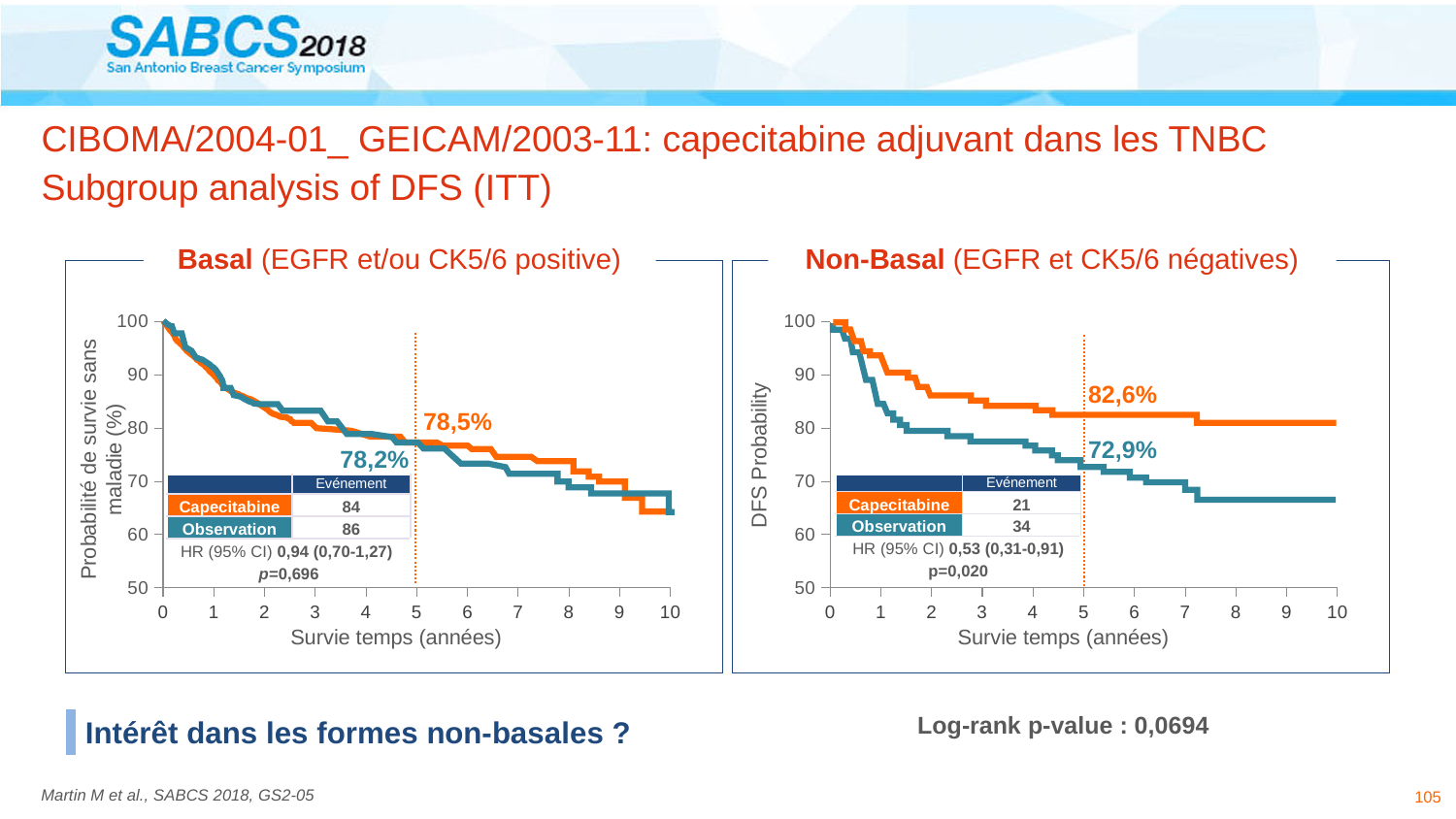
In the Basal chart, what is the 5-year survival probability labelled for the Observation curve? 78,2% In the Basal chart, do the survival curves rise or fall as time increases along the x axis? fall In the Non-Basal chart, what is the 5-year DFS probability labelled for the Capecitabine curve? 82,6% In the Non-Basal chart, which curve has the higher labelled 5-year DFS value, Capecitabine or Observation? Capecitabine In the Non-Basal chart, is the Observation curve at 10 years greater or less than 70? less In the Basal chart, what is the 5-year survival probability labelled for the Capecitabine curve? 78,5% In the Basal chart, how many events are reported for the Capecitabine group? 84 In the Non-Basal chart, how many events are reported for the Observation group? 34 In the Non-Basal chart, what is the difference between the labelled 5-year DFS values for Capecitabine and Observation? 9,7% How many curves (groups) are plotted in the Non-Basal chart? 2 In the Non-Basal chart, what is the 5-year DFS probability labelled for the Observation curve? 72,9% What type of chart is shown in the Basal panel? line chart